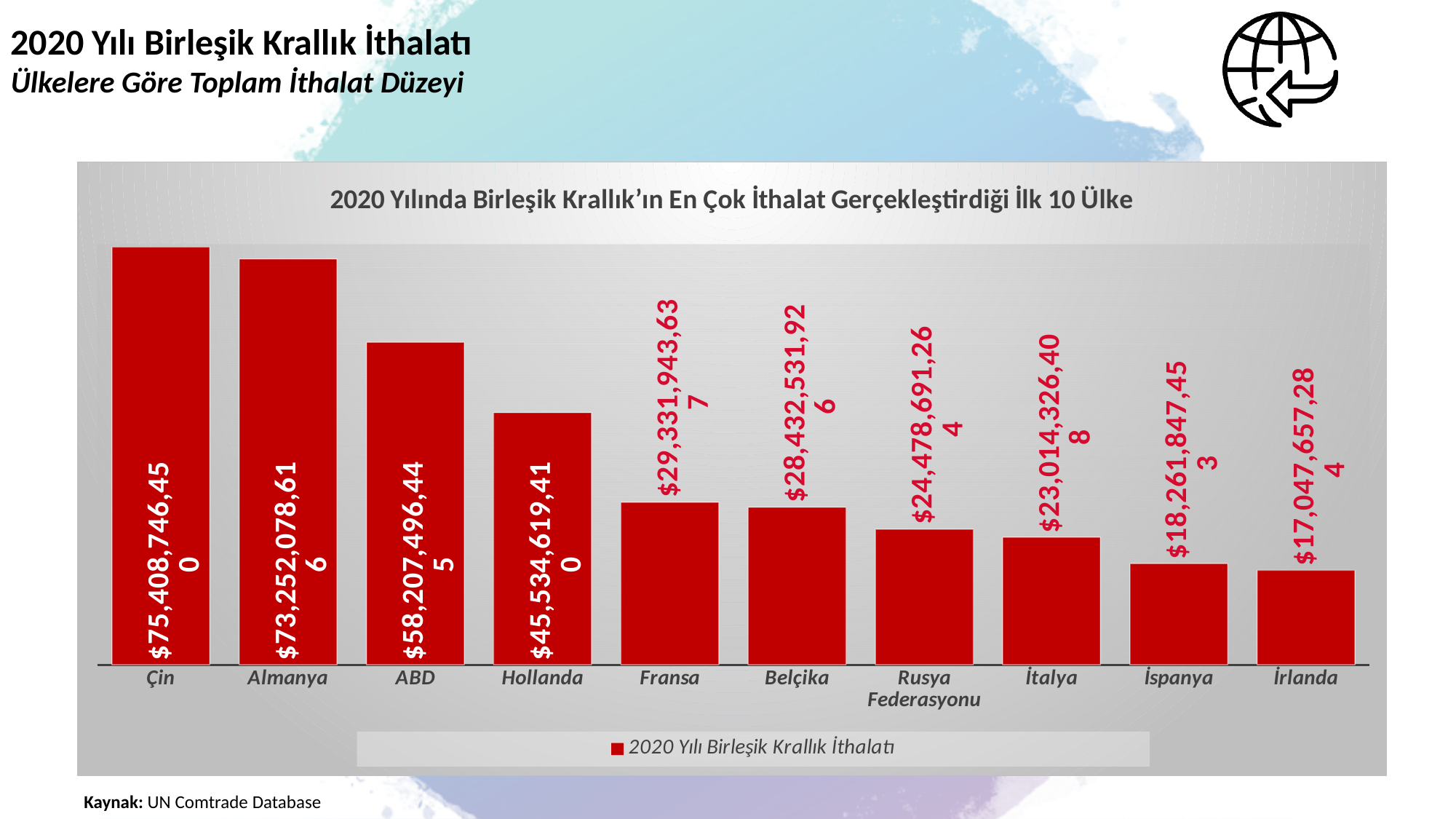
What is the value for İrlanda? $17,047,657,284 What is the value for Hollanda? $45,534,619,410 What is the value for Çin? $75,408,746,450 Which country has the highest value? Çin Which country has the lowest value? İrlanda Do the values rise or fall from left to right along the x axis? fall What is the value for Rusya Federasyonu? $24,478,691,264 How many countries are shown in the chart? 10 What is the difference between the values for Çin and Almanya? $2,156,667,834 What is the difference between the values for İspanya and İrlanda? $1,214,190,169 How many series does the legend list? 1 Which is larger, the value for ABD or the value for Hollanda? ABD